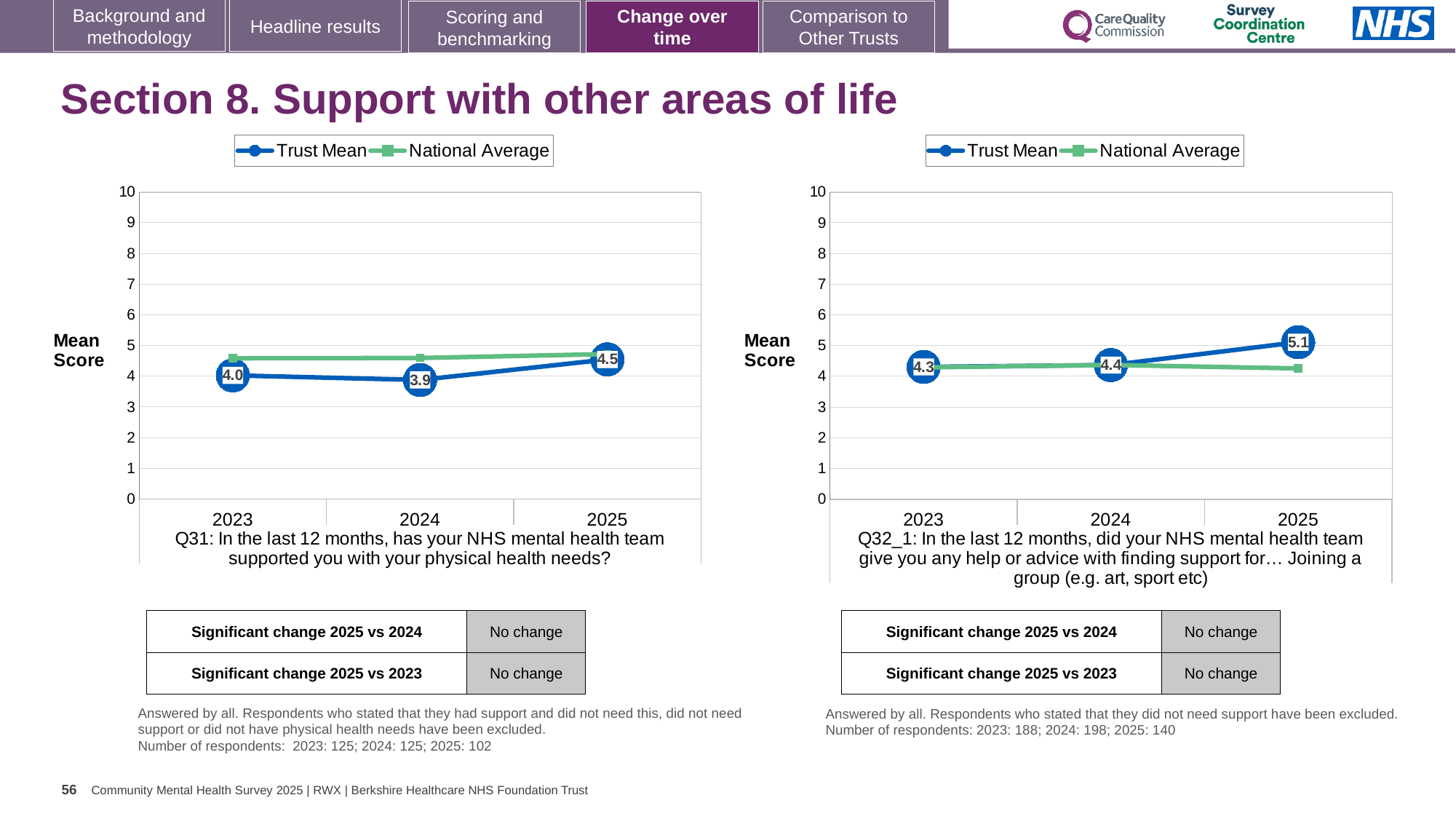
In the right chart (Q32_1), which year has the highest Trust Mean? 2025 How many series does the legend of the right chart (Q32_1) list? 2 In the right chart (Q32_1), what is the Trust Mean for 2023? 4.3 In the left chart (Q31), what is the Trust Mean for 2025? 4.5 In the right chart (Q32_1), what is the difference between the Trust Mean for 2025 and the Trust Mean for 2023? 0.8 In the right chart (Q32_1), is the National Average for 2025 greater or less than 5? less In the right chart (Q32_1), what is the Trust Mean for 2025? 5.1 In the left chart (Q31), what is the Trust Mean for 2024? 3.9 How many years are plotted on the x axis of the left chart (Q31)? 3 What kind of chart is the left chart (Q31)? line chart In the left chart (Q31), is the Trust Mean for 2025 larger or smaller than the Trust Mean for 2024? larger In the left chart (Q31), which year has the lowest Trust Mean? 2024